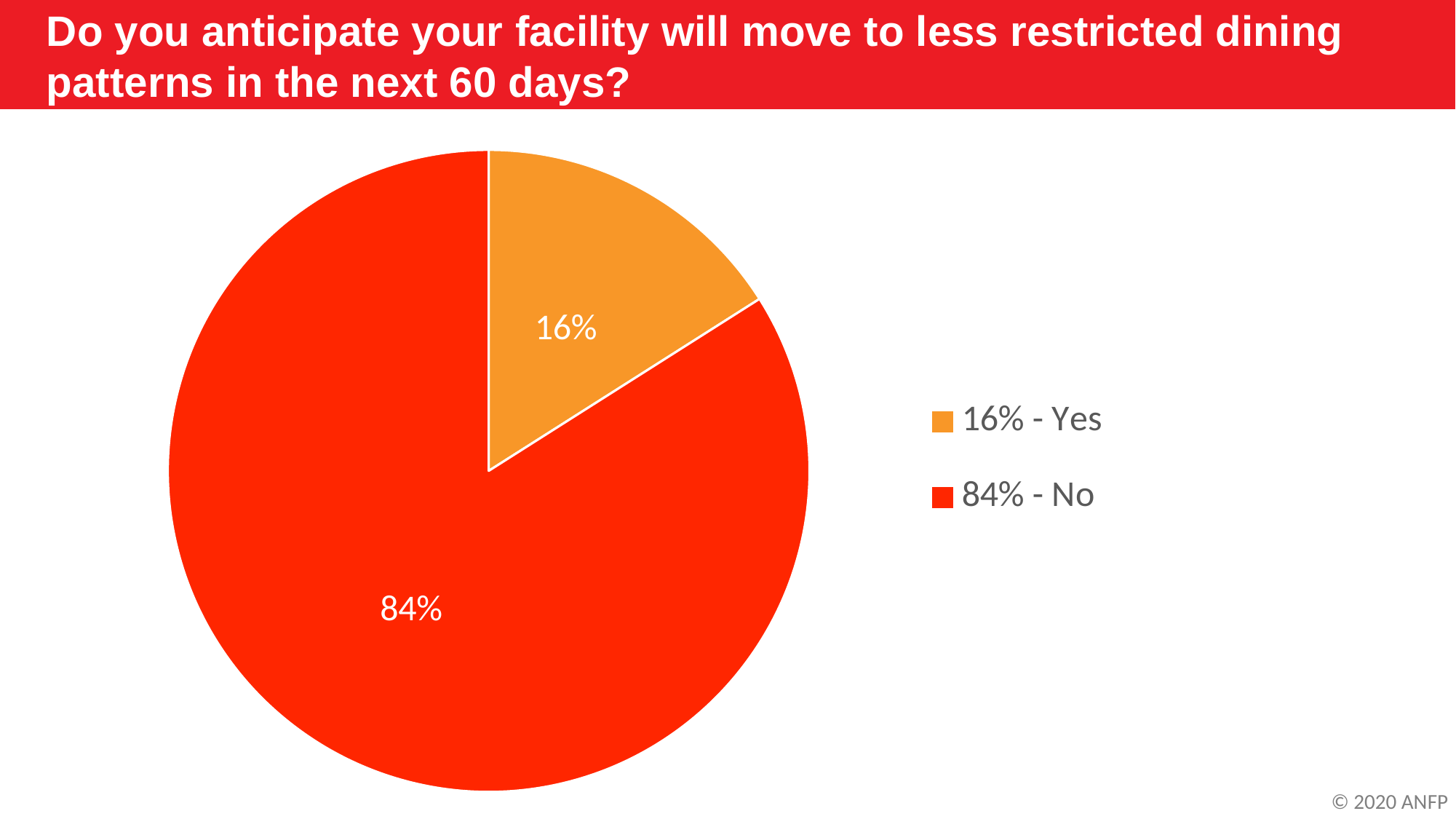
How many slices does the pie chart have? 2 What is the difference in percentage points between the No and Yes shares? 68 Which is larger, the Yes share or the No share? No How many entries does the legend list? 2 Which response has the largest share of the pie? No Which response has the smallest share of the pie? Yes What is the combined share of the Yes and No slices? 100% What question does the slide title ask? Do you anticipate your facility will move to less restricted dining patterns in the next 60 days? What share of respondents answered Yes? 16% What colour is the Yes slice? Orange What share of respondents answered No? 84% What kind of chart is shown on the slide? Pie chart